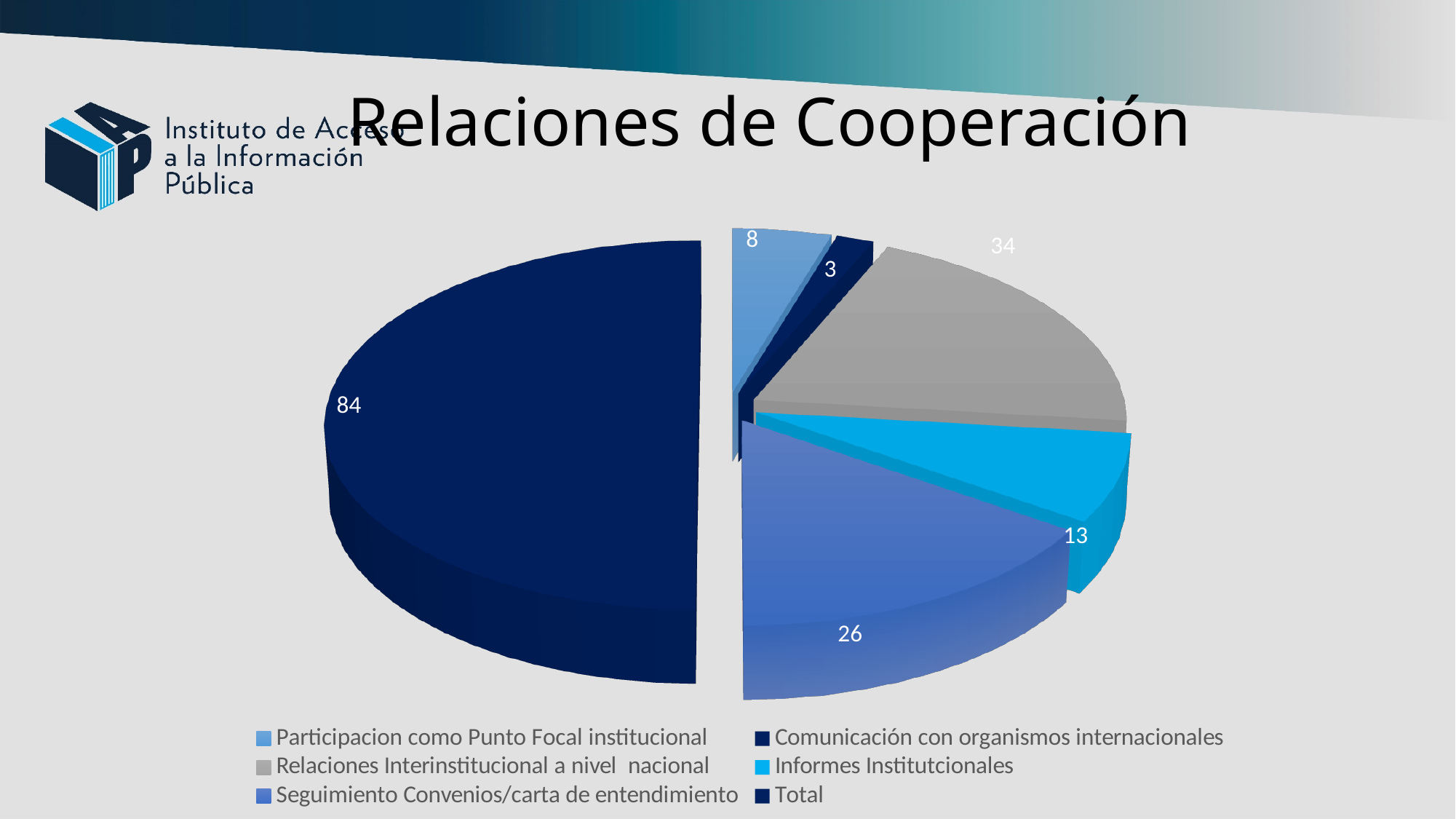
What is the value for Seguimiento Convenios/carta de entendimiento? 26 What is the value for Participacion como Punto Focal institucional? 8 What is the difference between Relaciones Interinstitucional a nivel nacional and Seguimiento Convenios/carta de entendimiento? 8 What type of chart is shown on the slide? Pie chart What is the value for Comunicación con organismos internacionales? 3 Which slice has the largest value? Total Which slice has the smallest value? Comunicación con organismos internacionales How many entries does the legend list? 6 What is the title of the chart? Relaciones de Cooperación Which is larger, Informes Institutcionales or Seguimiento Convenios/carta de entendimiento? Seguimiento Convenios/carta de entendimiento What is the value for Informes Institutcionales? 13 What is the value for Relaciones Interinstitucional a nivel nacional? 34